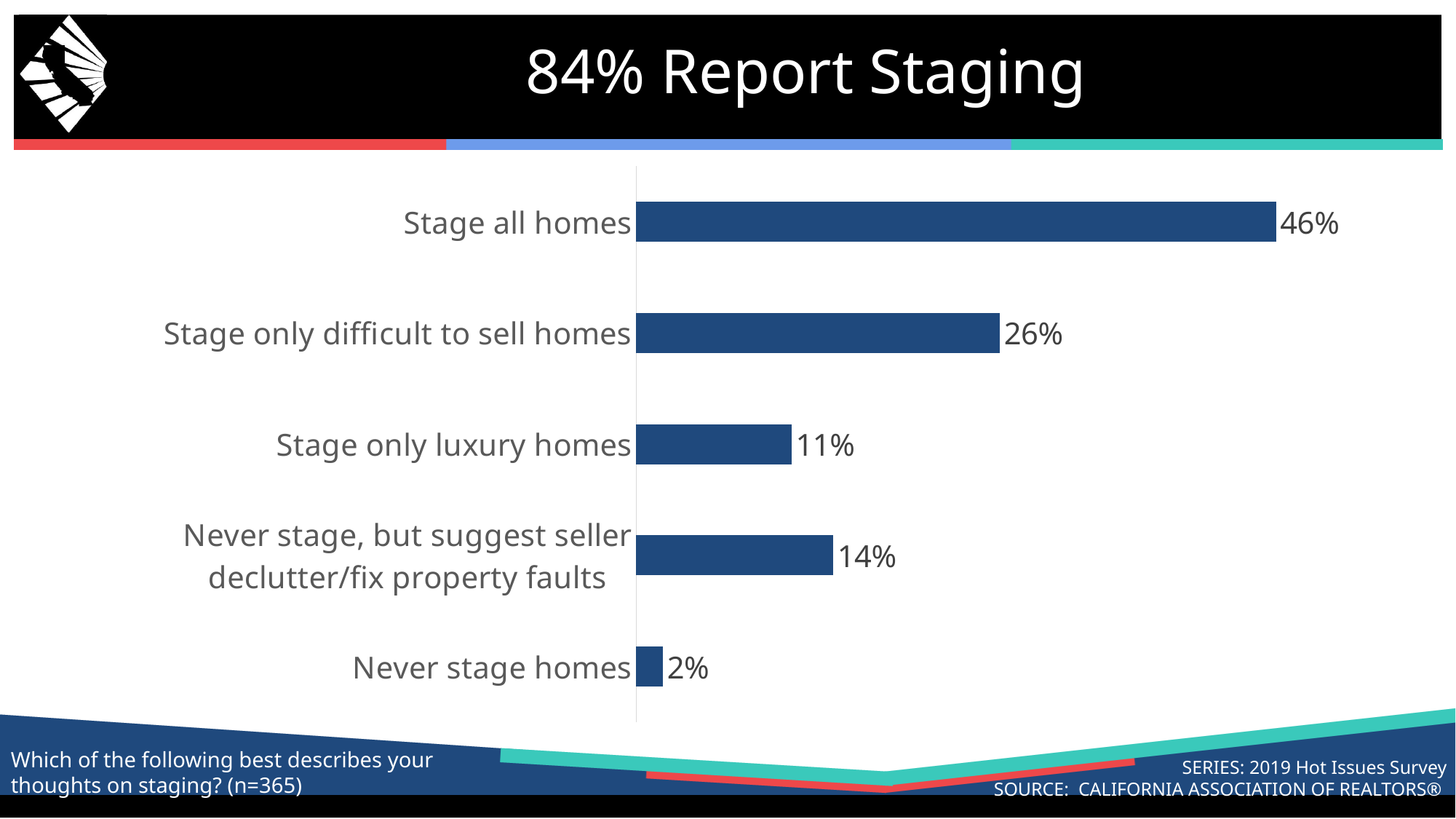
What is the value for "Stage only difficult to sell homes"? 26% What is the title of the slide? 84% Report Staging What kind of chart is shown on the slide? Bar chart Which category has the highest value? Stage all homes What percentage of respondents said they stage all homes? 46% Which category has the lowest value? Never stage homes What is the value for "Stage only luxury homes"? 11% What is the difference between "Stage all homes" and "Stage only difficult to sell homes"? 20 percentage points Which is larger: "Stage only luxury homes" or "Never stage, but suggest seller declutter/fix property faults"? Never stage, but suggest seller declutter/fix property faults How many categories are shown in the chart? 5 What is the value for "Never stage homes"? 2% What percentage of respondents never stage but suggest the seller declutter/fix property faults? 14%